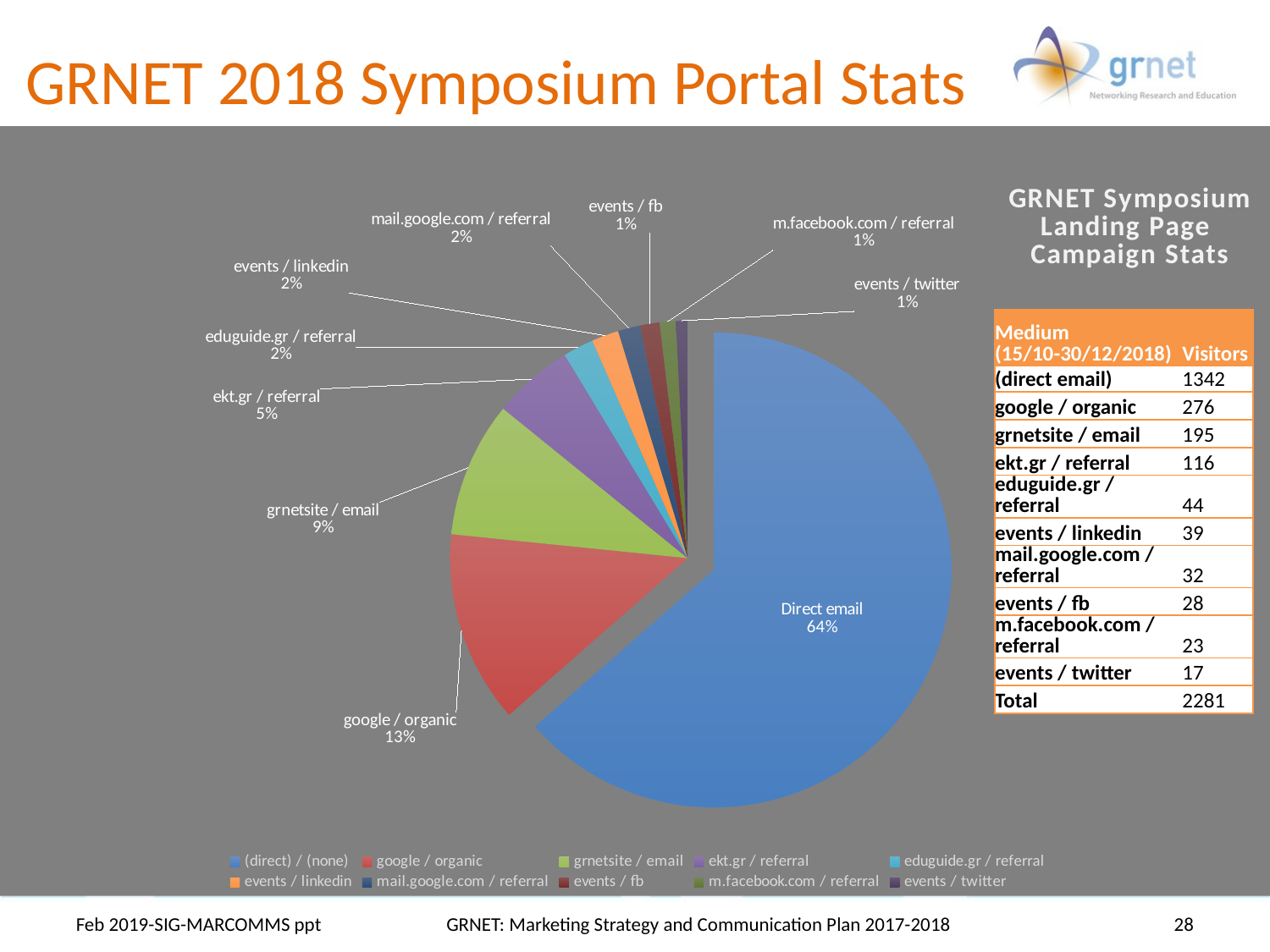
What share of the pie does events / twitter account for? 1% How many entries does the legend of the pie chart list? 10 How many slices does the pie chart have? 10 Which is larger in the pie chart, google / organic or grnetsite / email? google / organic What share of the pie does Direct email account for? 64% What is the difference in percentage points between the Direct email slice and the google / organic slice? 51 Which slice of the pie chart is the largest? Direct email What share of the pie does grnetsite / email account for? 9% What colour is the Direct email slice in the pie chart? blue What kind of chart is shown on the slide? pie chart